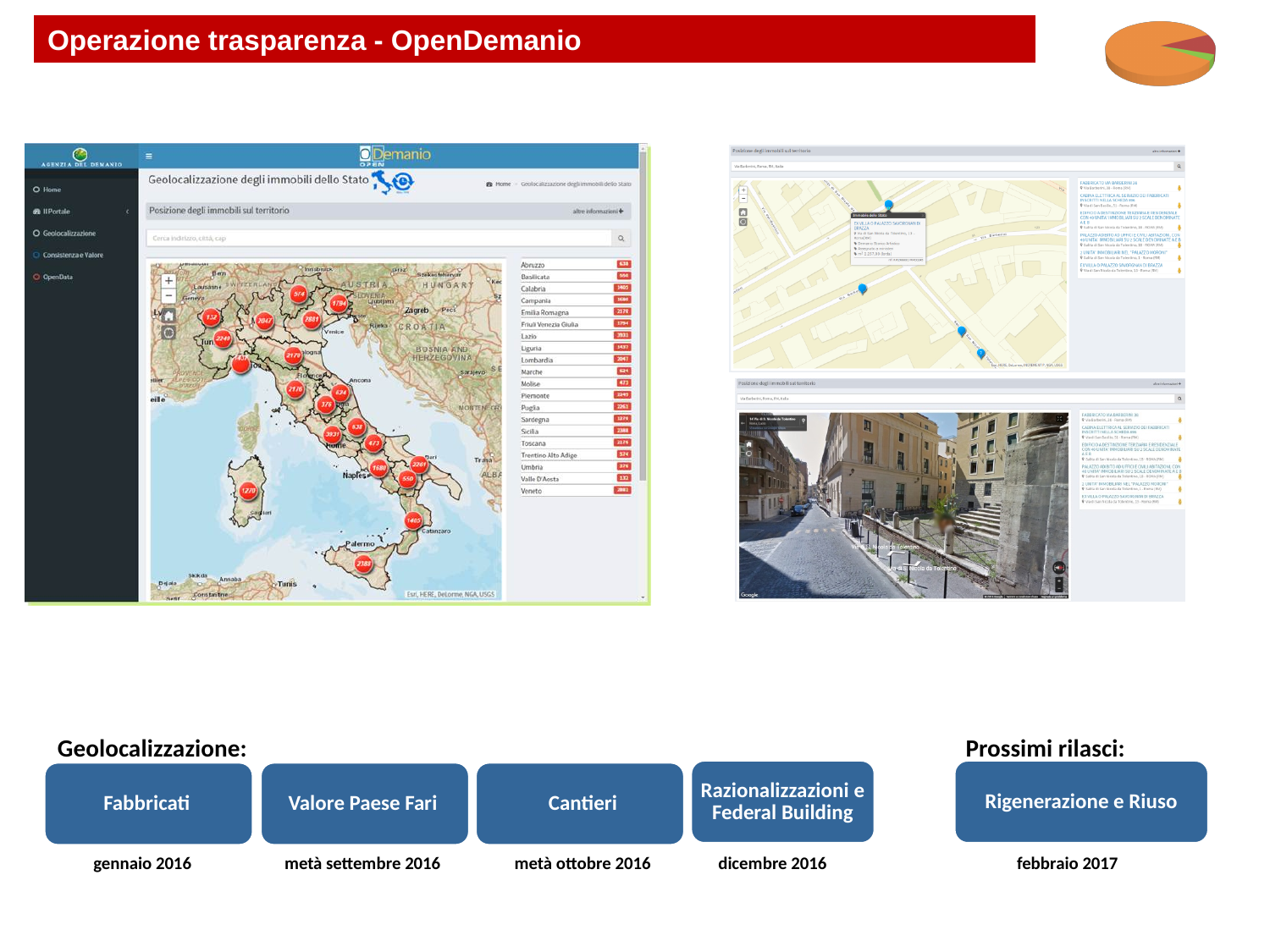
In the left screenshot, which region has the larger value, Sicilia or Sardegna? Sicilia In the left screenshot, which region has the larger value, Lazio or Veneto? Lazio What is the title of the slide? Operazione trasparenza - OpenDemanio What is the title of the page shown in the left screenshot? Geolocalizzazione degli immobili dello Stato In the left screenshot, what value is shown for Lazio in the table beside the map? 3931 In the left screenshot, which region has the highest number of properties in the table beside the map? Lazio In the left screenshot, how many regions are listed in the table beside the map of Italy? 20 In the left screenshot, what value is shown for Veneto in the table beside the map? 2881 In the left screenshot, which region has the lowest number of properties in the table beside the map? Valle D'Aosta What kind of visualisation is shown in the left screenshot of the OpenDemanio portal? A map of Italy with bubble markers per region In the left screenshot, what value is shown for Valle D'Aosta in the table beside the map? 132